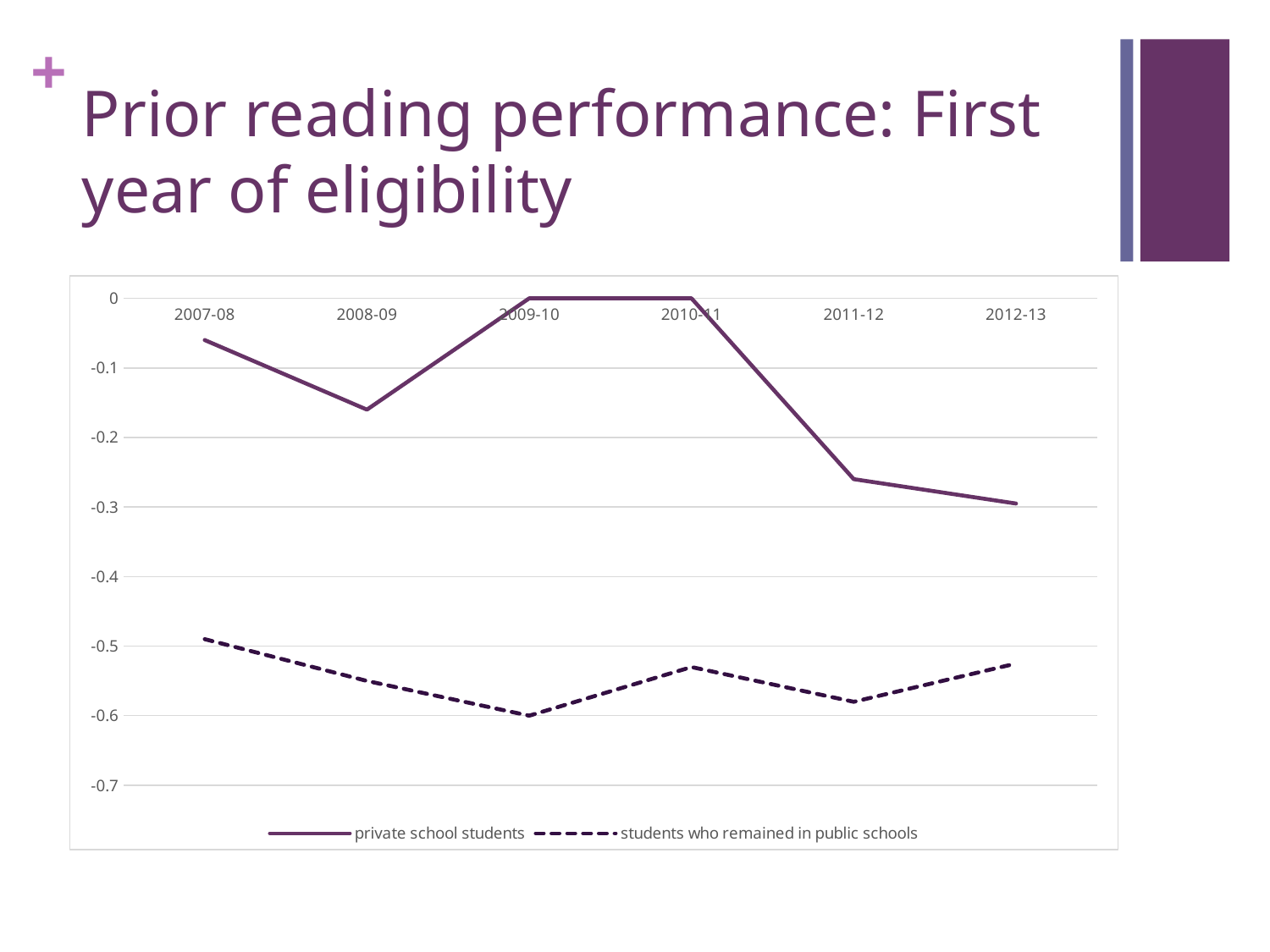
Is the value for private school students in 2011-12 greater or less than -0.2? less Which series has the higher value in 2012-13, private school students or students who remained in public schools? private school students In which year is the value for students who remained in public schools highest? 2007-08 Is the value for students who remained in public schools in 2011-12 greater or less than -0.5? less What is the value for students who remained in public schools in 2009-10? -0.6 How many series does the legend list? 2 What is the value for private school students in 2010-11? 0 What kind of chart is shown on the slide? line chart What is the value for private school students in 2009-10? 0 Is the value for private school students in 2008-09 greater or less than -0.2? greater How many school years are shown on the x axis? 6 In which year is the value for private school students lowest? 2012-13